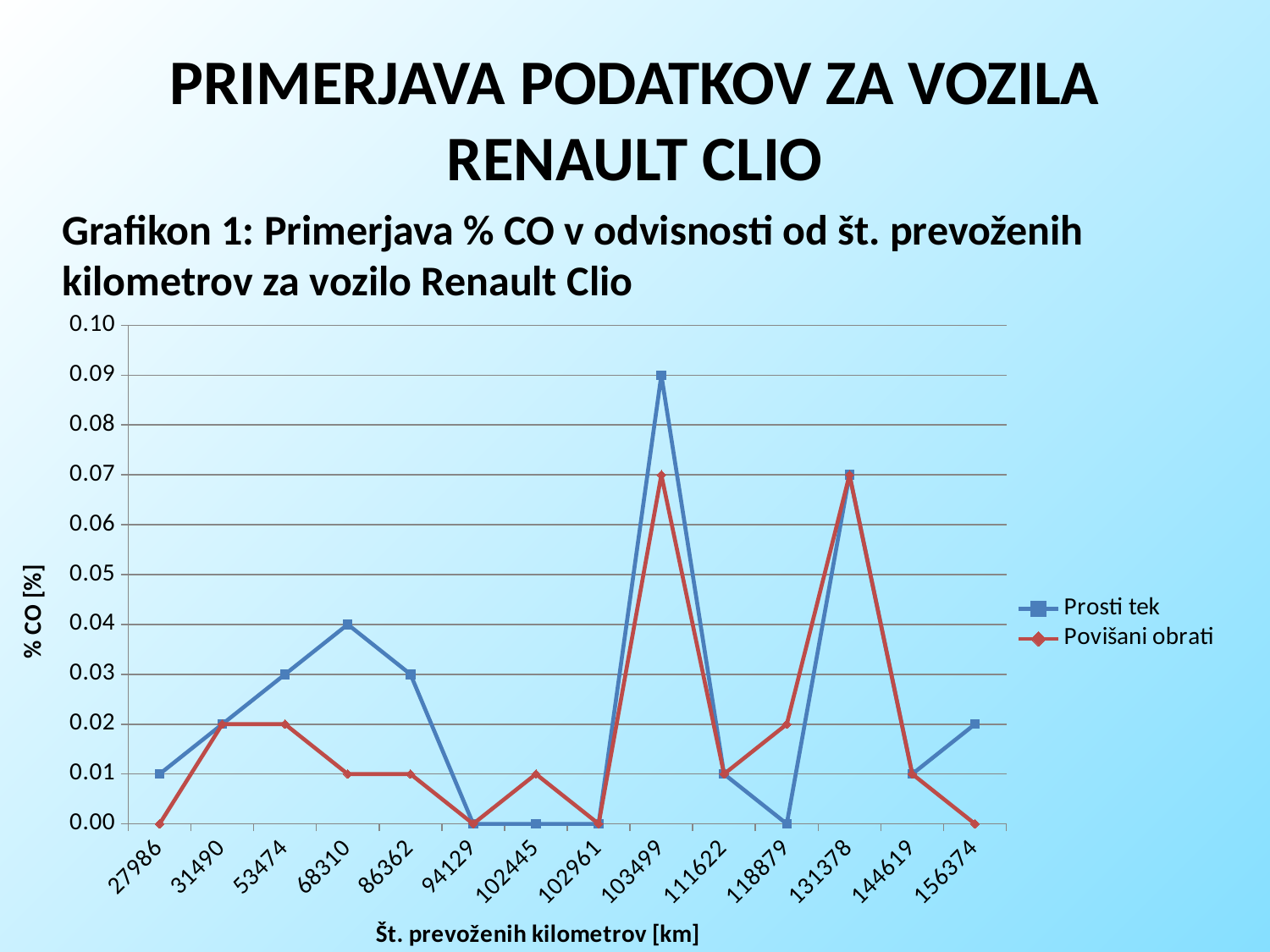
Does the Prosti tek series rise or fall between 27986 km and 68310 km? rise What is the difference between Prosti tek and Povišani obrati at 103499 km? 0.02 Is the value for Prosti tek at 103499 km greater or less than 0.05? greater What is the label of the y axis? % CO [%] At 118879 km, which series has the larger % CO value, Prosti tek or Povišani obrati? Povišani obrati What is the % CO value for Povišani obrati at 131378 km? 0.07 What kind of chart is shown on the slide? line chart What is the % CO value for Prosti tek at 103499 km? 0.09 How many kilometre categories are shown on the x axis? 14 What is the % CO value for Prosti tek at 68310 km? 0.04 At which kilometre reading does Prosti tek reach its highest % CO value? 103499 How many series does the legend list? 2